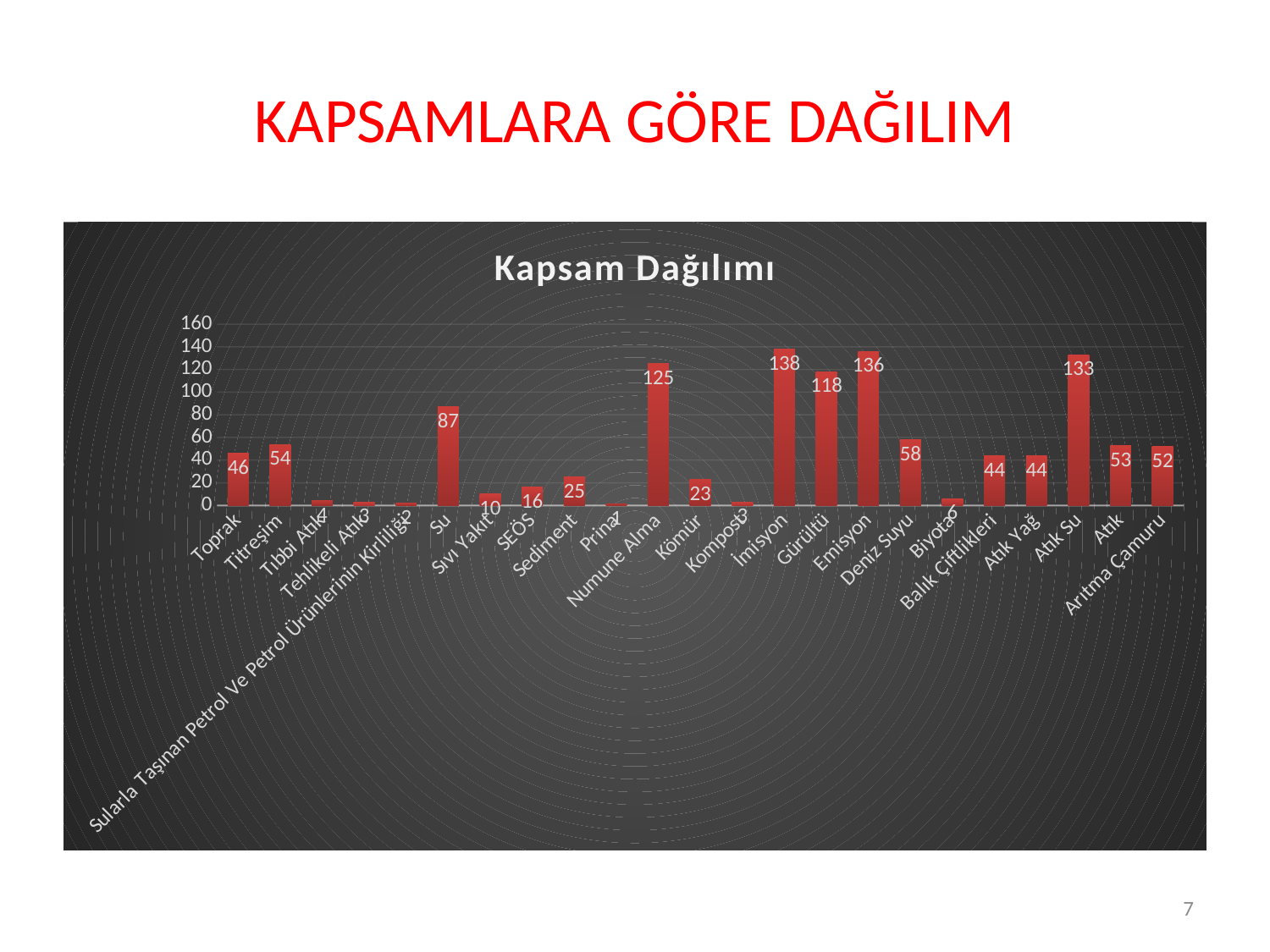
What is the title of the chart? Kapsam Dağılımı What is the difference between the values for İmisyon and Emisyon? 2 Which is larger, the value for Atık Su or the value for Numune Alma? Atık Su What is the value for Su in the Kapsam Dağılımı chart? 87 What kind of chart is shown on the slide? bar chart What is the value for Numune Alma? 125 What is the difference between the values for Su and Titreşim? 33 What is the value for Arıtma Çamuru? 52 Is the value for Deniz Suyu greater or less than 40? greater What is the value for Gürültü? 118 How many categories are shown on the x axis of the chart? 23 Which category has the highest value? İmisyon